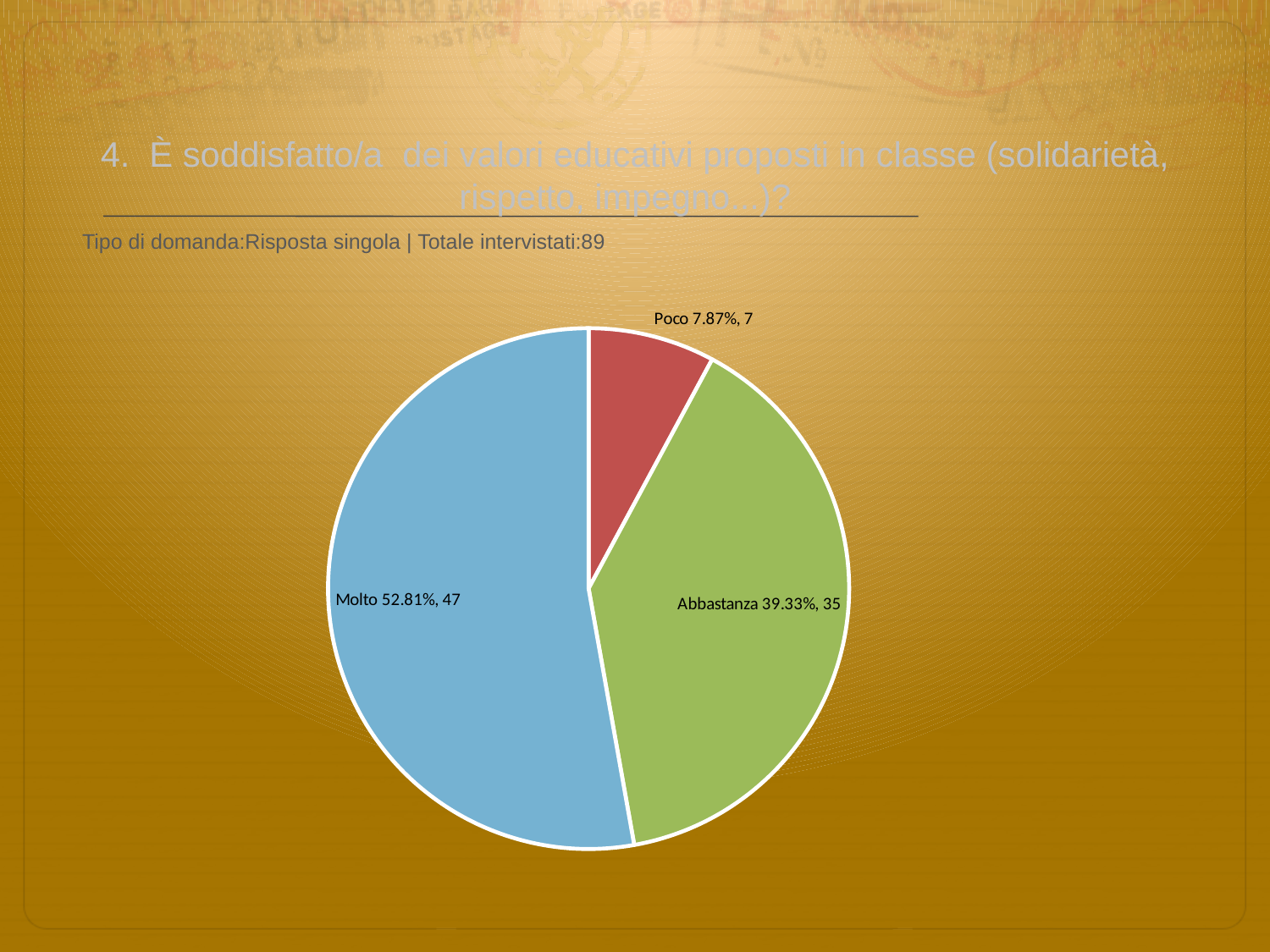
What share of the pie does the Abbastanza slice represent? 39.33% What kind of chart is shown on the slide? pie chart How many respondents answered Abbastanza? 35 How many slices does the pie chart have? 3 What percentage is shown for the Molto slice? 52.81% What colour is the Molto slice? blue How many respondents answered Poco? 7 Which category has the largest slice? Molto Which has more respondents, Abbastanza or Poco? Abbastanza What is the difference in respondent count between Molto and Abbastanza? 12 What percentage is shown for the Poco slice? 7.87% Which category has the smallest slice? Poco